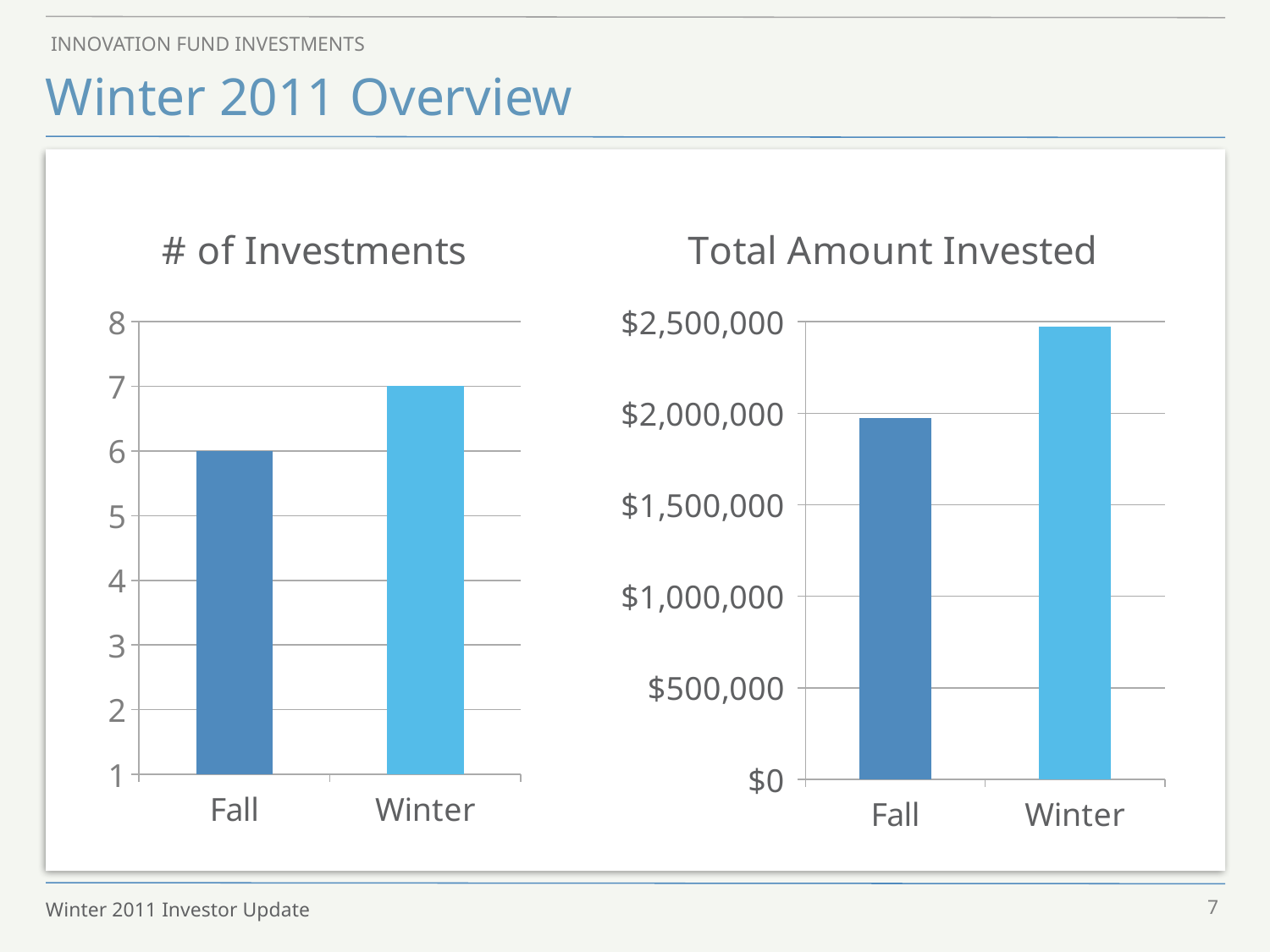
In the 'Total Amount Invested' chart, is the value for Fall greater or less than $1,500,000? greater In the '# of Investments' chart, what is the value for Winter? 7 In the 'Total Amount Invested' chart, do the values rise or fall from Fall to Winter? rise What kind of chart is the 'Total Amount Invested' chart? bar chart In the 'Total Amount Invested' chart, is the value for Winter greater or less than $2,000,000? greater In the '# of Investments' chart, which category has the higher value? Winter In the 'Total Amount Invested' chart, which is larger, the value for Fall or the value for Winter? Winter What is the title of the chart on the right side of the slide? Total Amount Invested In the '# of Investments' chart, how many categories are shown on the x axis? 2 In the '# of Investments' chart, what is the difference between the Winter and Fall values? 1 In the '# of Investments' chart, which category has the lower value? Fall In the '# of Investments' chart, what is the value for Fall? 6